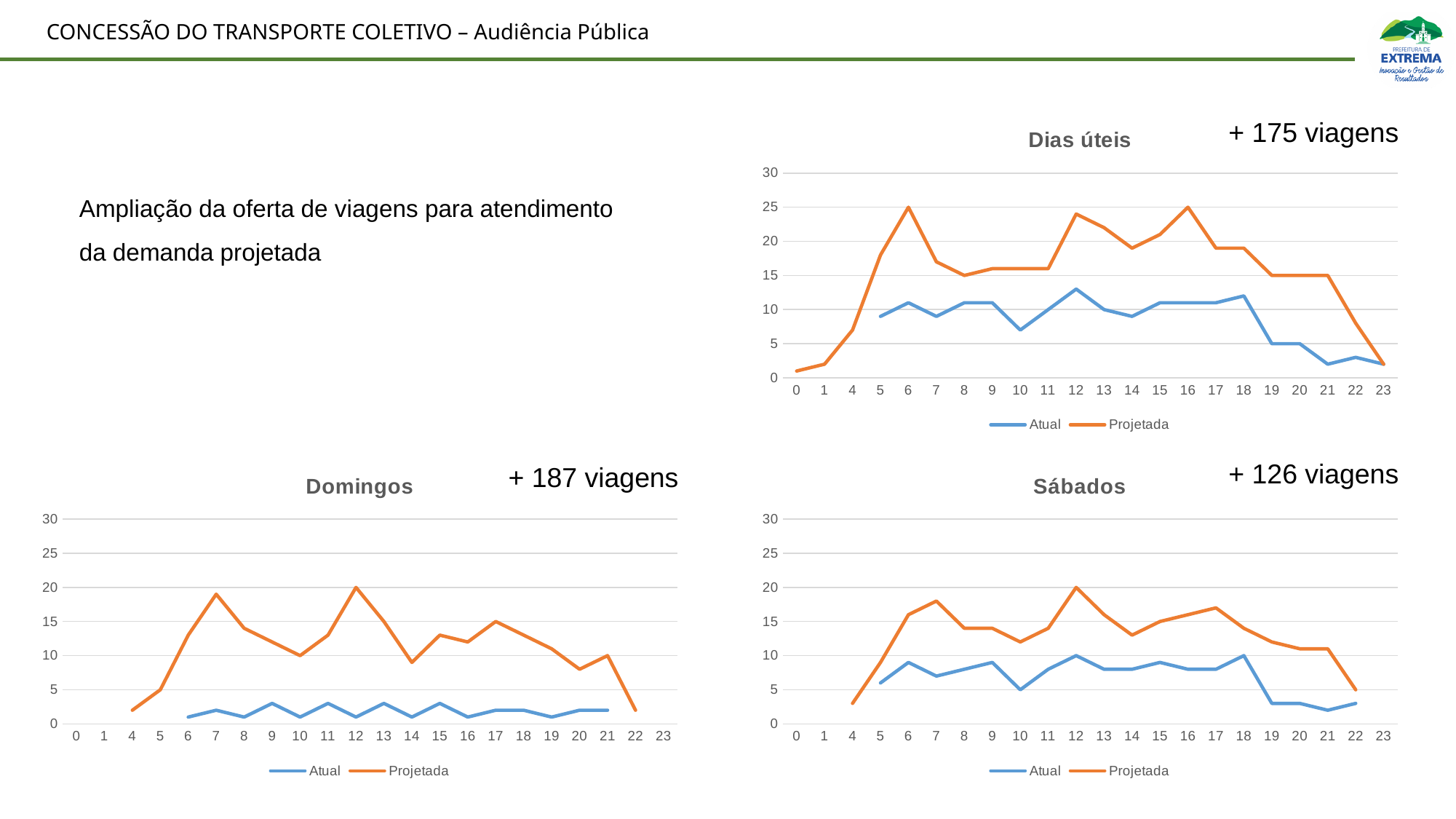
What number of additional trips is annotated next to the 'Domingos' chart? + 187 viagens In the 'Domingos' chart, what is the Projetada value at hour 12? 20 How many hour labels are shown on the x axis of the 'Domingos' chart? 22 In the 'Dias úteis' chart, what is the Projetada value at hour 6? 25 In the 'Sábados' chart, is the Projetada value at hour 7 greater or less than 15? greater In the 'Dias úteis' chart, at which hour does the Projetada series reach its highest value? 6 and 16 In the 'Sábados' chart, at which hour does the Projetada series reach its highest value? 12 In the 'Dias úteis' chart, which series is higher at hour 12, Atual or Projetada? Projetada How many series does the legend of the 'Sábados' chart list? 2 In the 'Domingos' chart, is the Atual value at hour 9 greater or less than 5? less What kind of chart is the 'Dias úteis' chart? line chart In the 'Dias úteis' chart, does the Projetada series rise or fall from hour 18 to hour 23? fall